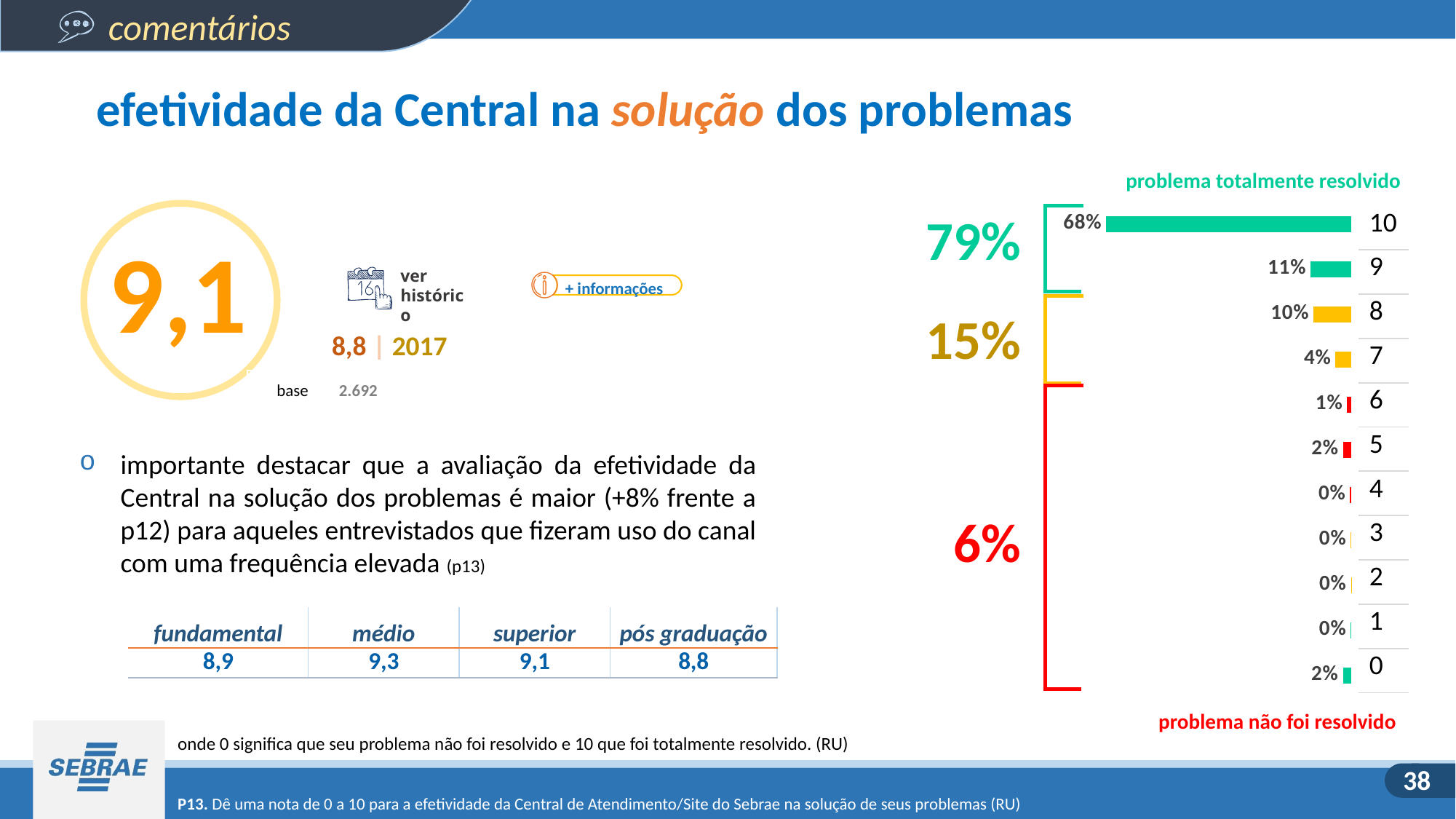
What percentage of respondents gave a score of 8? 10% What percentage of respondents gave a score of 9? 11% What percentage of respondents gave a score of 0? 2% What is the combined percentage shown for scores 7 and 8? 15% What is the combined percentage shown for scores 9 and 10 (problema totalmente resolvido)? 79% Which has a larger share of respondents: score 8 or score 7? Score 8 What type of chart is used to show the distribution of scores? Bar chart How many score categories are shown in the bar chart? 11 What label is shown at the bottom of the chart for the lowest scores? problema não foi resolvido What is the difference in percentage points between the share giving a score of 10 and the share giving a score of 9? 57 What percentage of respondents gave a score of 10 for the effectiveness of the Central in solving problems? 68% Which score category has the highest percentage of respondents? 10